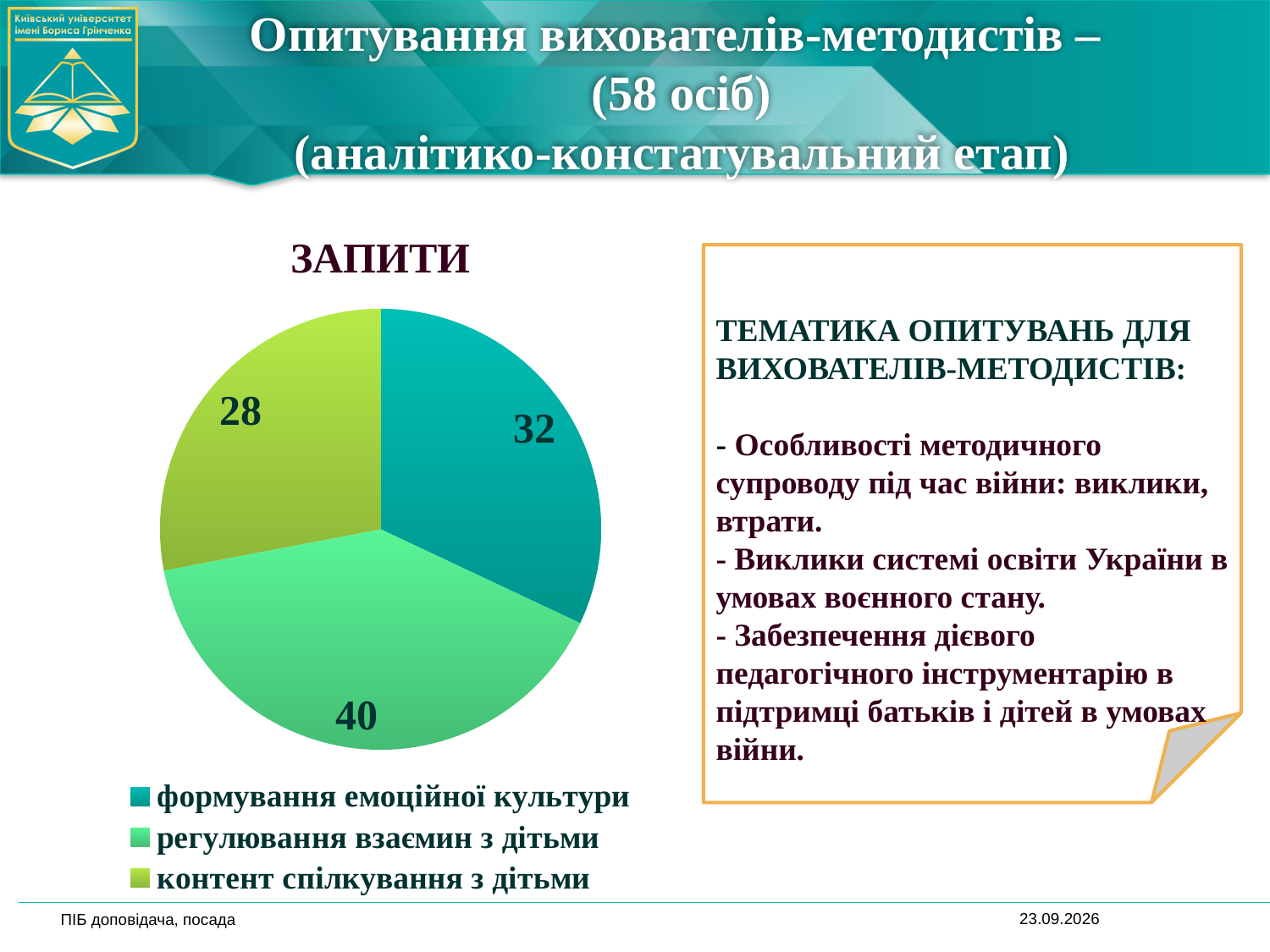
What is the difference between the values for "регулювання взаємин з дітьми" and "контент спілкування з дітьми"? 12 What is the value for "регулювання взаємин з дітьми"? 40 What is the value for "формування емоційної культури"? 32 Which is larger: the value for "формування емоційної культури" or for "контент спілкування з дітьми"? формування емоційної культури What type of chart is shown on the slide? pie chart What is the title of the chart? ЗАПИТИ What is the value for "контент спілкування з дітьми"? 28 Which category has the smallest slice of the pie? контент спілкування з дітьми What share of the pie does "регулювання взаємин з дітьми" represent? 40% Which category has the largest slice of the pie? регулювання взаємин з дітьми How many slices does the pie chart have? 3 What is the total of all slices in the pie chart? 100